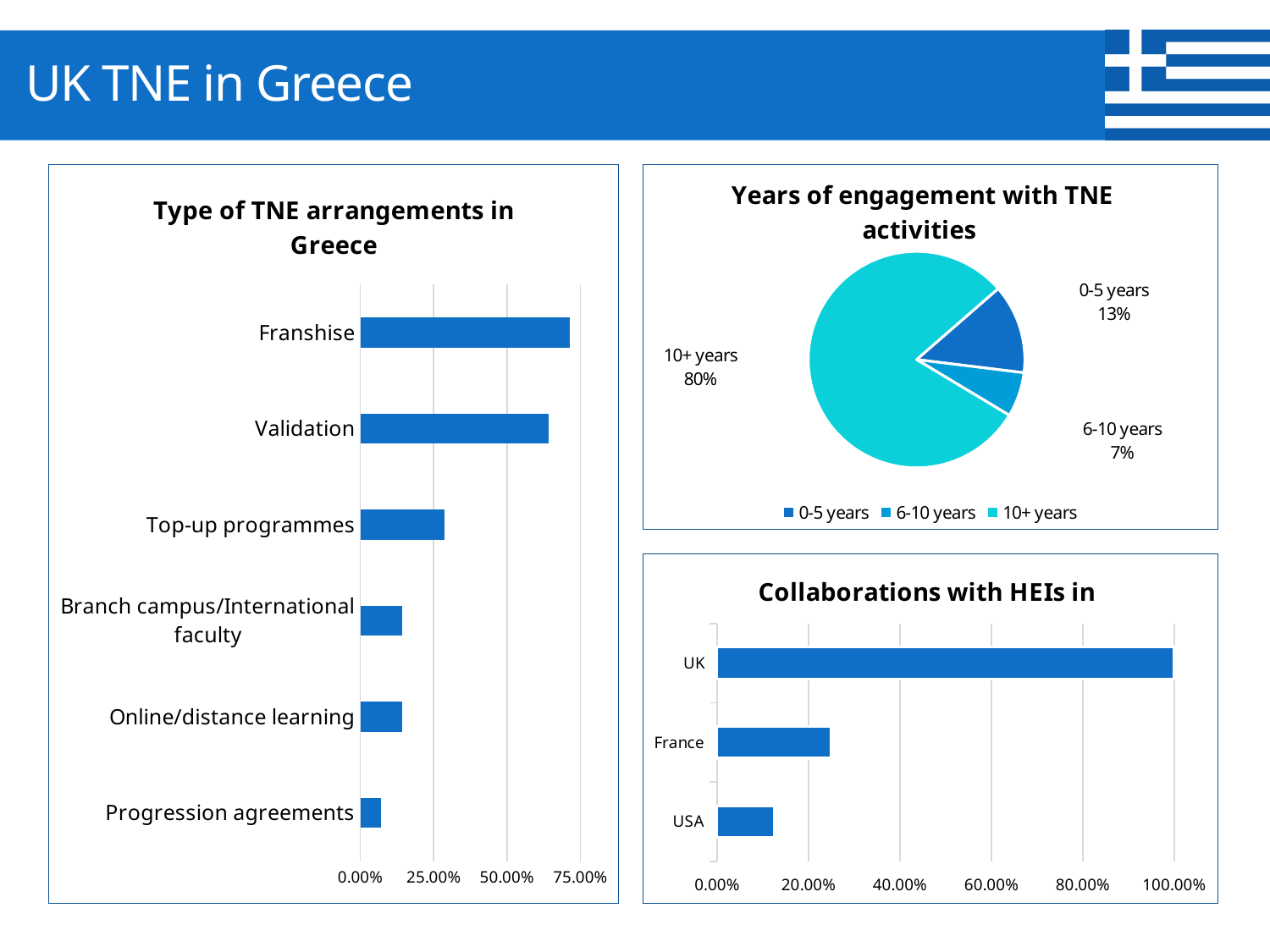
How many entries does the legend of the 'Years of engagement with TNE activities' chart list? 3 In the 'Collaborations with HEIs in' chart, is the value for France greater or less than 40.00%? less In the 'Type of TNE arrangements in Greece' chart, which category has the lowest value? Progression agreements In the 'Type of TNE arrangements in Greece' chart, is the value for Top-up programmes greater or less than 50.00%? less In the 'Years of engagement with TNE activities' pie chart, which slice is the smallest? 6-10 years In the 'Collaborations with HEIs in' chart, which country has the highest value? UK In the 'Years of engagement with TNE activities' pie chart, what share is 10+ years? 80% In the 'Type of TNE arrangements in Greece' chart, how many categories are shown? 6 In the 'Type of TNE arrangements in Greece' chart, which category has the highest value? Franshise In the 'Years of engagement with TNE activities' pie chart, what is the value for 0-5 years? 13% What kind of chart is the 'Type of TNE arrangements in Greece' chart? bar chart In the 'Type of TNE arrangements in Greece' chart, which is larger: Validation or Top-up programmes? Validation